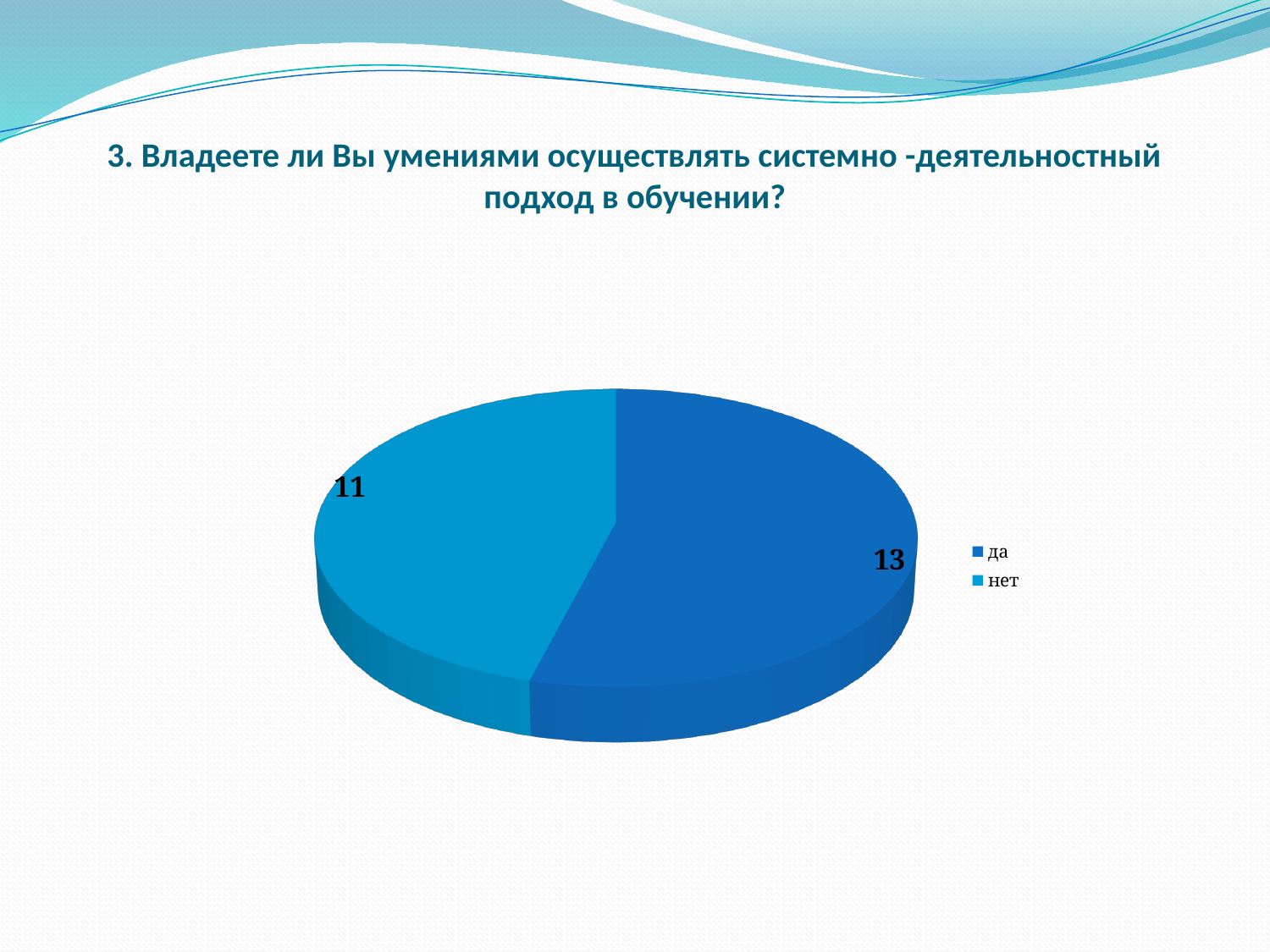
Which category has the smallest slice? нет How many entries does the legend list? 2 How many categories does the pie chart have? 2 What is the value for "нет"? 11 Which category has the largest slice? да Which legend entry is shown in the lighter blue colour? нет Which is larger, the value for "да" or the value for "нет"? да What is the difference between the values for "да" and "нет"? 2 What is the value for "да"? 13 What is the title of the slide above the chart? 3. Владеете ли Вы умениями осуществлять системно -деятельностный подход в обучении? What is the total of all slices in the pie chart? 24 What type of chart is shown on the slide? pie chart